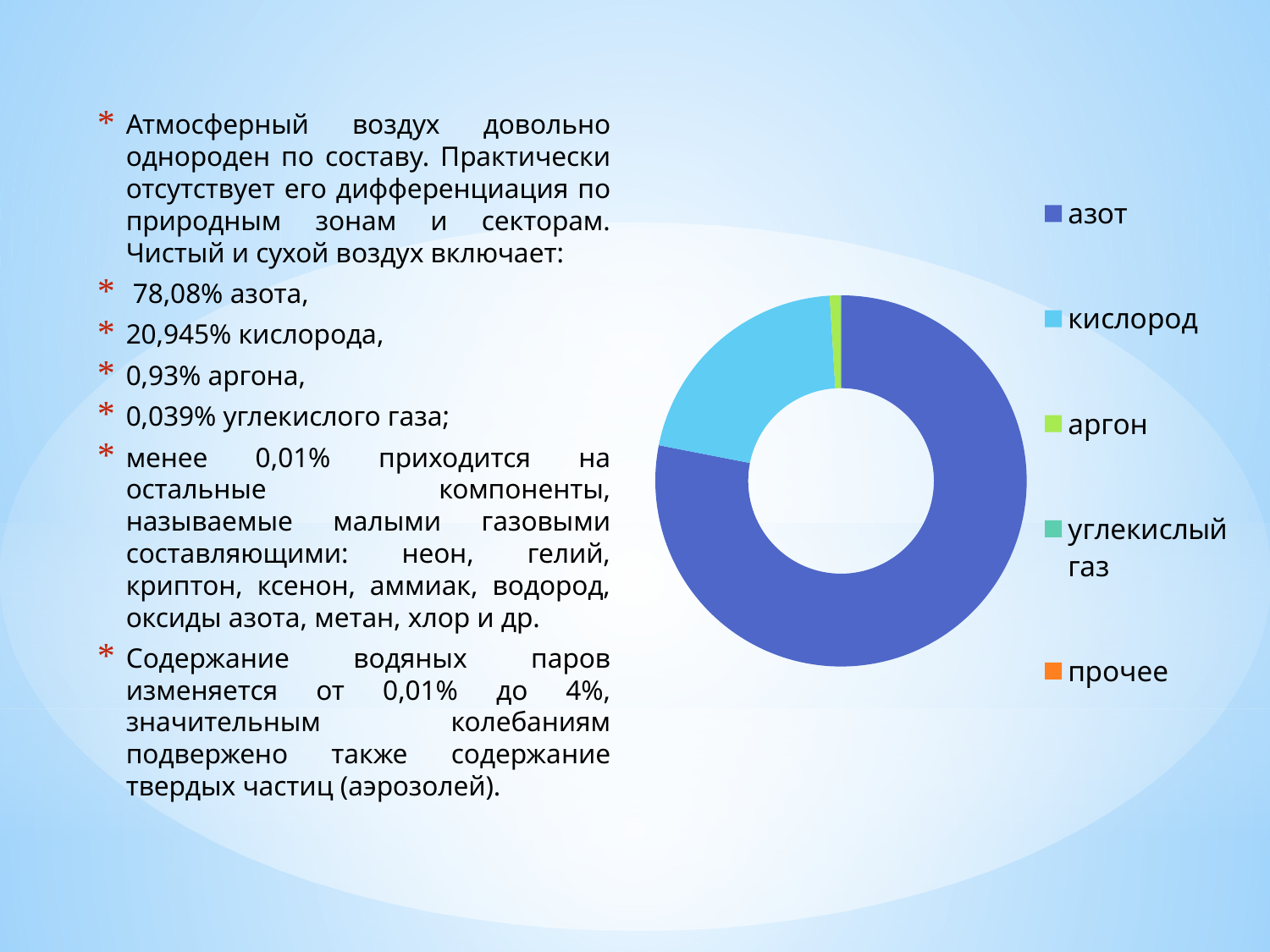
Is the share of аргон in the chart greater or less than 10%? less Which slice is larger, азот or кислород? азот How many categories does the chart's legend list? 5 Is the share of кислород in the chart greater or less than 50%? less Is the share of азот in the chart greater or less than 50%? greater Which legend entry is shown in green? аргон Which slice is larger, кислород or аргон? кислород What kind of chart is shown on the slide? doughnut (pie) chart Which category has the largest slice in the chart? азот What colour represents азот in the chart? blue